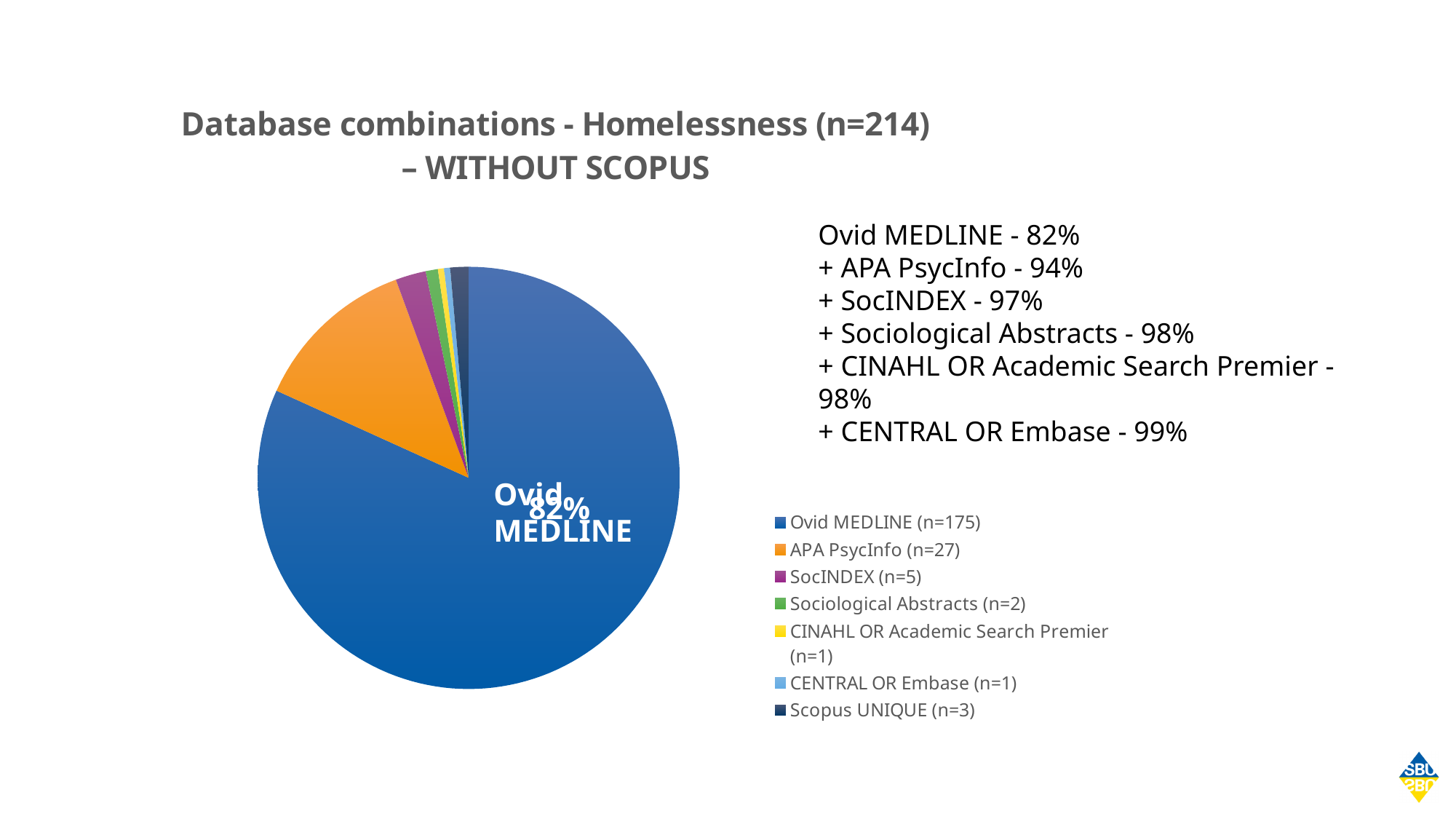
What share of the pie does the Ovid MEDLINE slice represent, according to the data label? 82% What is the title of the chart on the slide? Database combinations - Homelessness (n=214) – WITHOUT SCOPUS What is the difference between the n values for Ovid MEDLINE and APA PsycInfo? 148 Which has a larger n value, APA PsycInfo or SocINDEX? APA PsycInfo What is the n value shown in the legend for Scopus UNIQUE? 3 What is the n value shown in the legend for SocINDEX? 5 How many categories does the legend of the pie chart list? 7 What kind of chart is shown on the slide? Pie chart What is the n value shown in the legend for Sociological Abstracts? 2 Which category has the largest slice of the pie chart? Ovid MEDLINE What is the n value shown in the legend for APA PsycInfo? 27 What colour is the APA PsycInfo slice in the pie chart? Orange